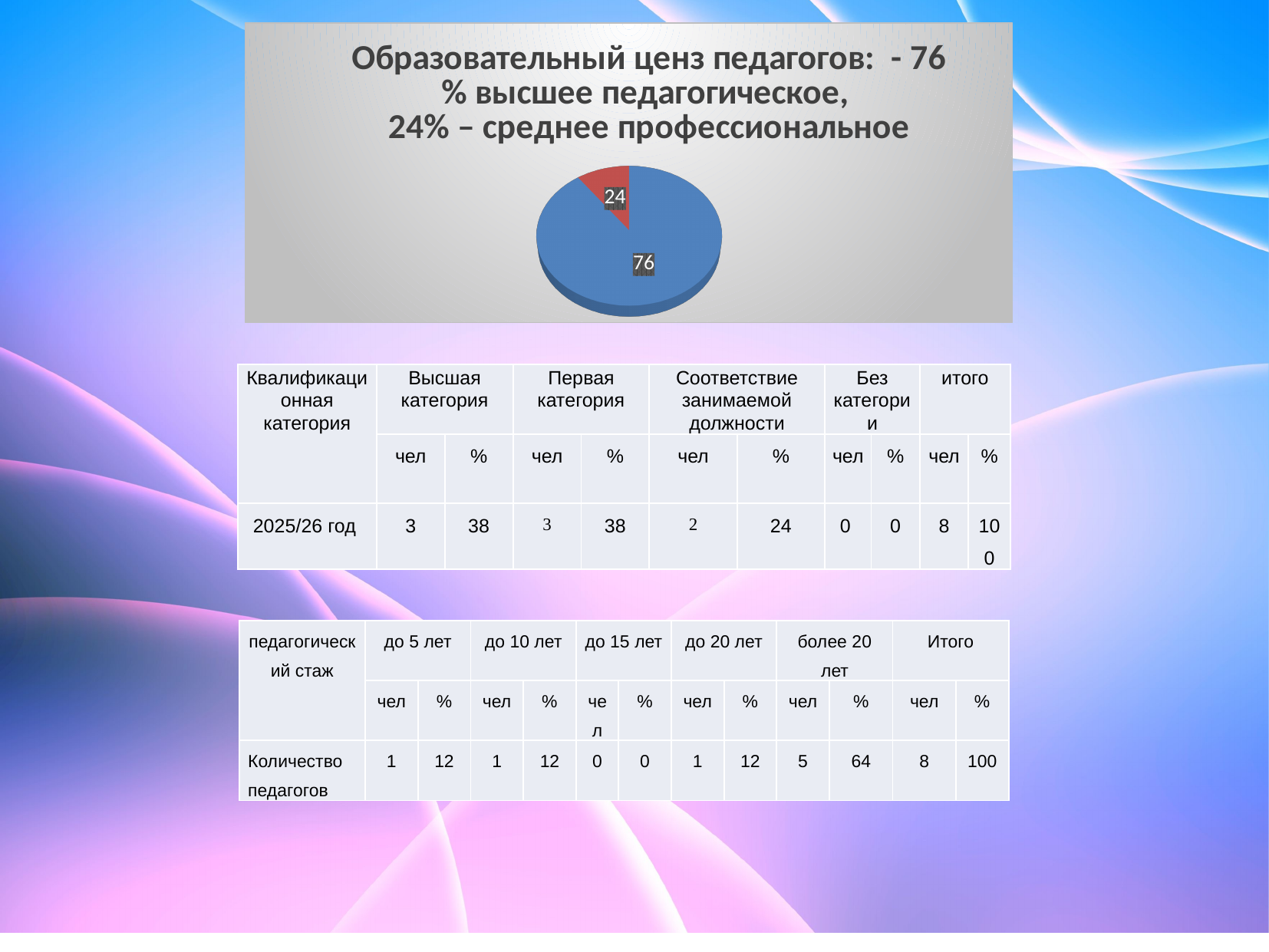
What value is printed on the smaller slice of the pie chart? 24 Which is larger on the pie chart: the blue slice or the red slice? the blue slice How many slices does the pie chart have? 2 According to the chart title, what share of teachers have higher pedagogical education (высшее педагогическое)? 76 % What kind of chart is shown on the slide? pie chart What colour is the slice labelled 24 on the pie chart? red What is the total of the two values shown on the pie chart? 100 Which slice of the pie chart is the smallest? 24 (среднее профессиональное) What is the difference between the two values shown on the pie chart? 52 According to the chart title, what share of teachers have secondary professional education (среднее профессиональное)? 24% Which slice of the pie chart is the largest? 76 (высшее педагогическое) What value is printed on the larger slice of the pie chart? 76